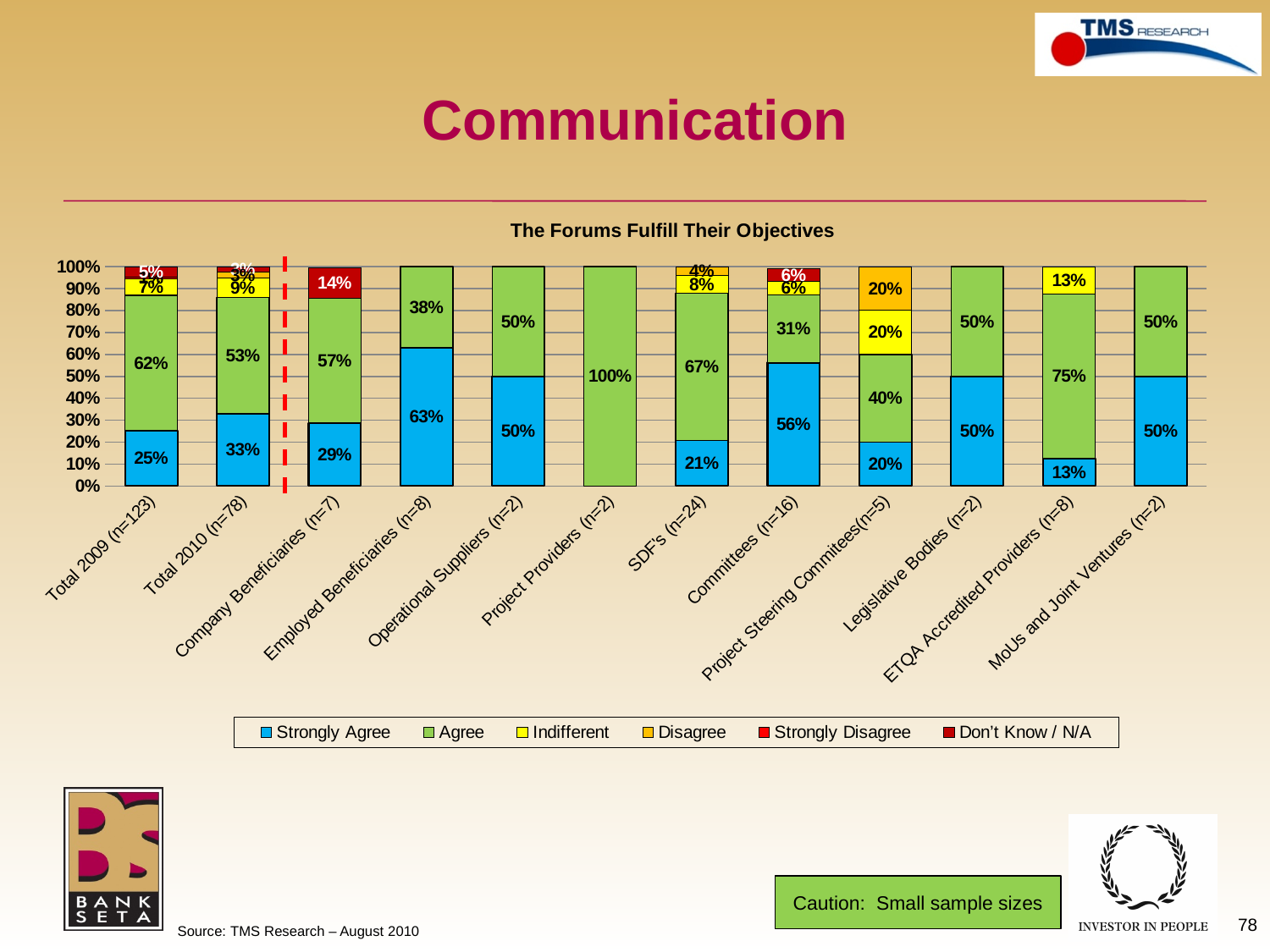
What kind of chart is shown on the slide? Stacked bar chart Which has the larger Agree value, SDF's (n=24) or Committees (n=16)? SDF's (n=24) What is the title of the chart? The Forums Fulfill Their Objectives By how many percentage points does the Strongly Agree value for Total 2010 (n=78) exceed that for Total 2009 (n=123)? 8 percentage points What is the Agree value for ETQA Accredited Providers (n=8)? 75% What is the Agree value for Project Providers (n=2)? 100% How many categories are shown along the x axis of the chart? 12 What is the Strongly Agree value for Total 2009 (n=123)? 25% How many series does the chart's legend list? 6 What is the Strongly Agree value for Employed Beneficiaries (n=8)? 63% Which category has the highest Strongly Agree value? Employed Beneficiaries (n=8) Which category has the highest Agree value? Project Providers (n=2)